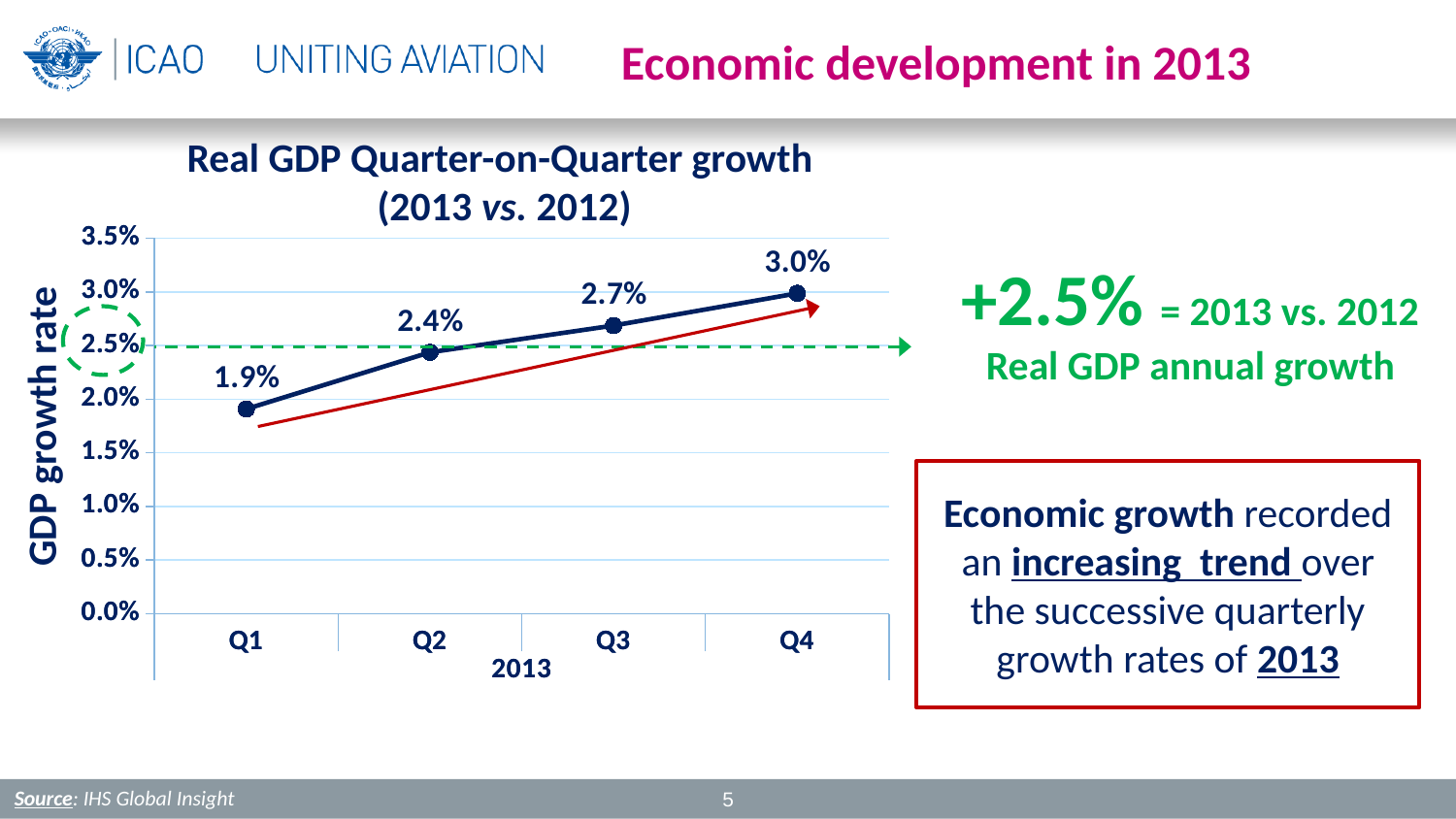
Which quarter has the lowest GDP growth rate in the chart? Q1 What kind of chart is used to show Real GDP quarter-on-quarter growth? Line chart Which quarter has a higher growth rate, Q2 or Q3? Q3 Do the quarterly growth rates rise or fall from Q1 to Q4 in 2013? Rise What is the Real GDP quarter-on-quarter growth rate for Q1 2013? 1.9% What is the Real GDP quarter-on-quarter growth rate for Q3 2013? 2.7% What is the difference between the Q4 and Q1 growth rates? 1.1% How many quarters are plotted in the chart? 4 Which quarter has the highest GDP growth rate in the chart? Q4 What is the label of the vertical axis of the chart? GDP growth rate What is the difference between the Q2 and Q1 growth rates? 0.5% What is the Real GDP quarter-on-quarter growth rate for Q4 2013? 3.0%